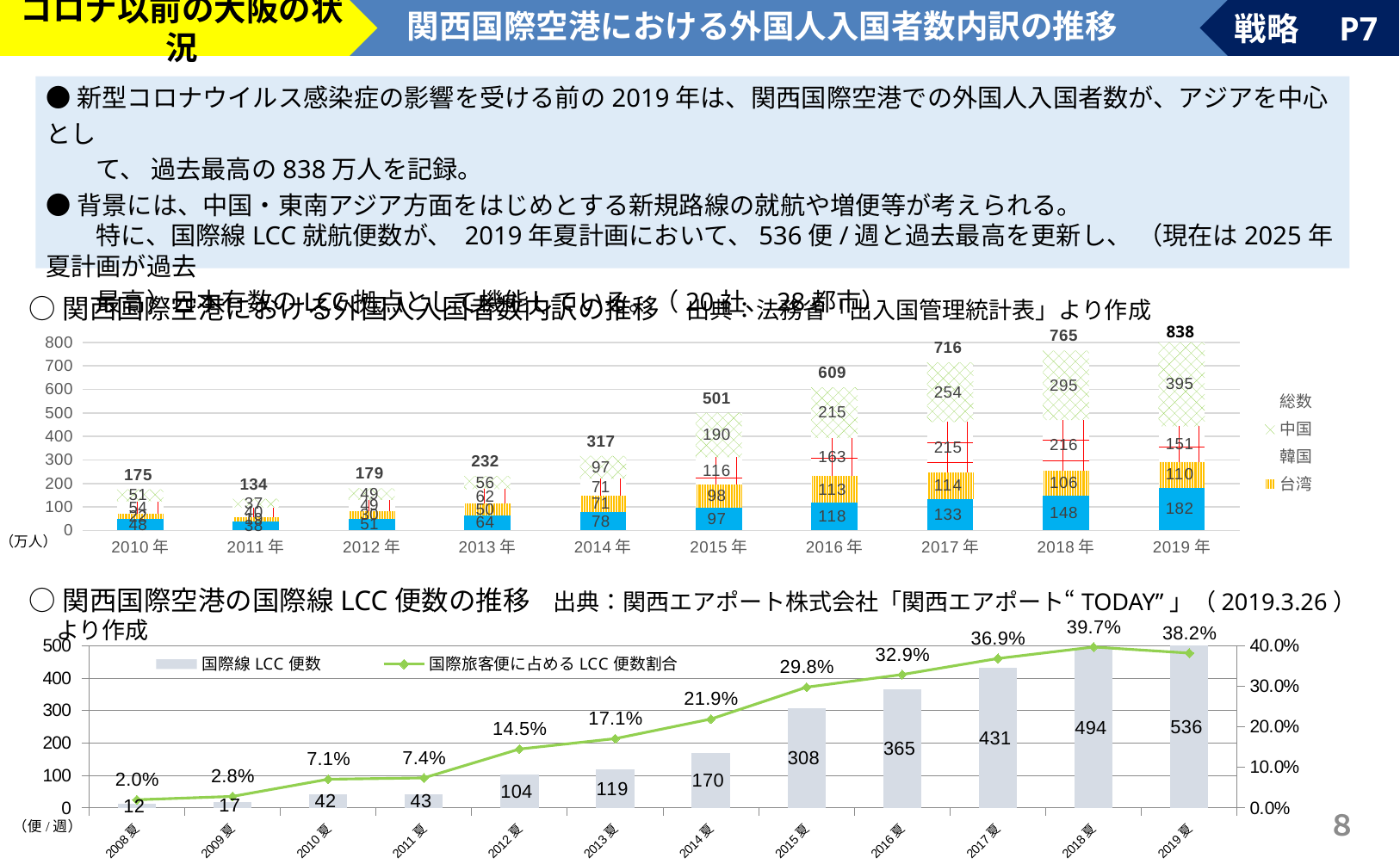
In the bottom chart (国際線LCC便数の推移), what is the difference in 国際線LCC便数 between 2015夏 and 2014夏? 138 In the bottom chart (国際線LCC便数の推移), what is the 国際旅客便に占めるLCC便数割合 for 2018夏? 39.7% In the top chart (外国人入国者数内訳の推移), what is the 中国 value for 2019年? 395 In the top chart (外国人入国者数内訳の推移), how many years are shown on the x axis? 10 In the bottom chart (国際線LCC便数の推移), how many series does the legend list? 2 In the bottom chart (国際線LCC便数の推移), which year has the highest 国際旅客便に占めるLCC便数割合? 2018夏 In the top chart (外国人入国者数内訳の推移), what is the difference between the totals for 2019年 and 2018年? 73 In the bottom chart (国際線LCC便数の推移), what is the number of 国際線LCC便数 for 2019夏? 536 In the top chart (外国人入国者数内訳の推移), what is the total (総数) for 2011年? 134 In the bottom chart (国際線LCC便数の推移), is the 国際線LCC便数 for 2016夏 greater or less than 300? greater In the top chart (外国人入国者数内訳の推移), what is the total (総数) for 2019年? 838 In the top chart (外国人入国者数内訳の推移), which year has the lowest total (総数)? 2011年